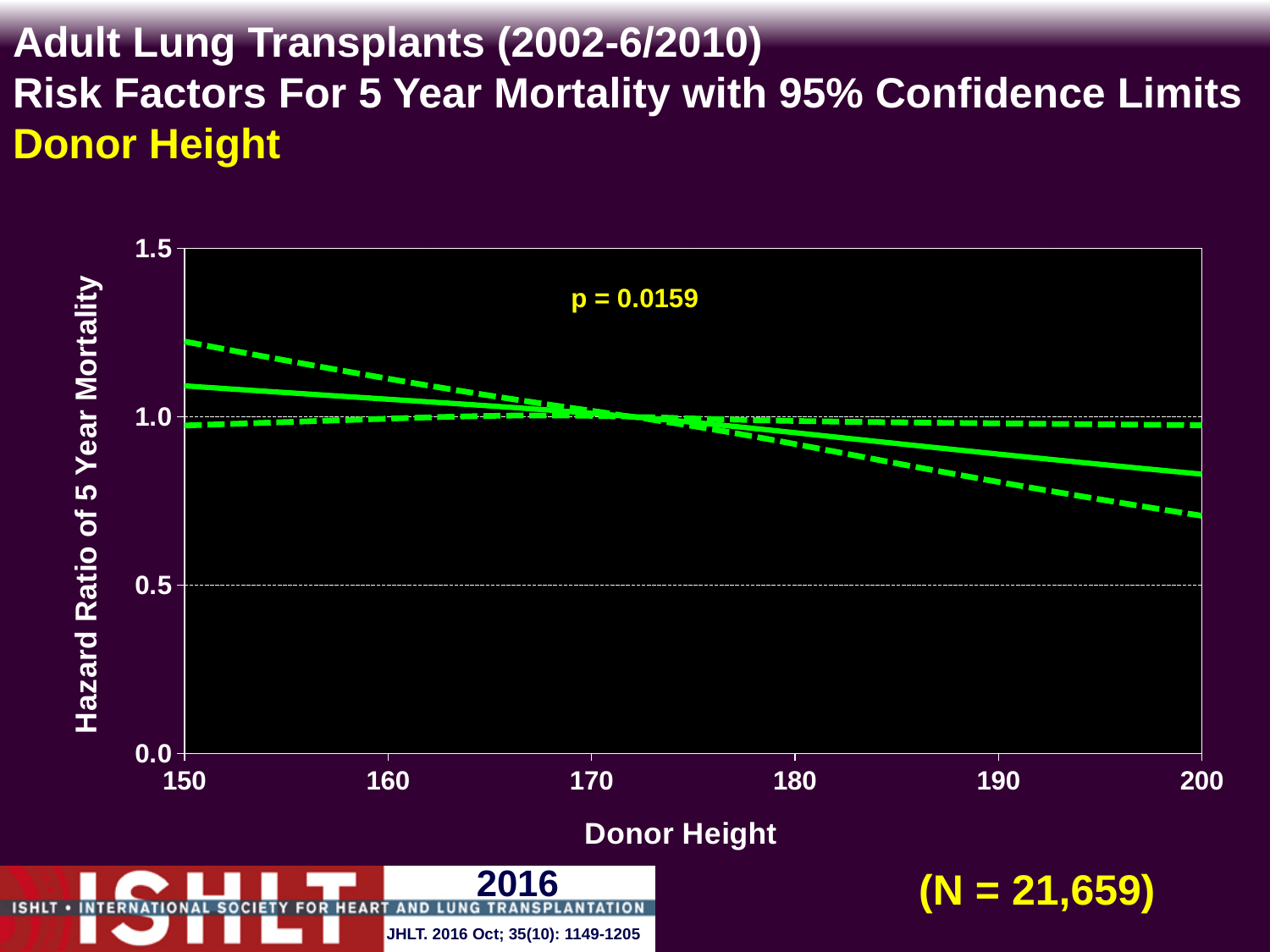
What kind of chart is shown on the slide? line chart What p-value is printed on the chart? p = 0.0159 Is the hazard ratio on the solid line at a donor height of 150 greater or less than 1.0? greater What is the label of the x axis? Donor Height Is the lower dashed confidence limit at a donor height of 200 greater or less than 1.0? less Is the upper dashed confidence limit at a donor height of 150 greater or less than 1.0? greater What is the label of the y axis? Hazard Ratio of 5 Year Mortality Does the solid hazard ratio line rise or fall as donor height increases from 150 to 200? fall What is the sample size (N) shown on the slide? N = 21,659 What is the highest value shown on the y axis? 1.5 How many lines are plotted on the chart? 3